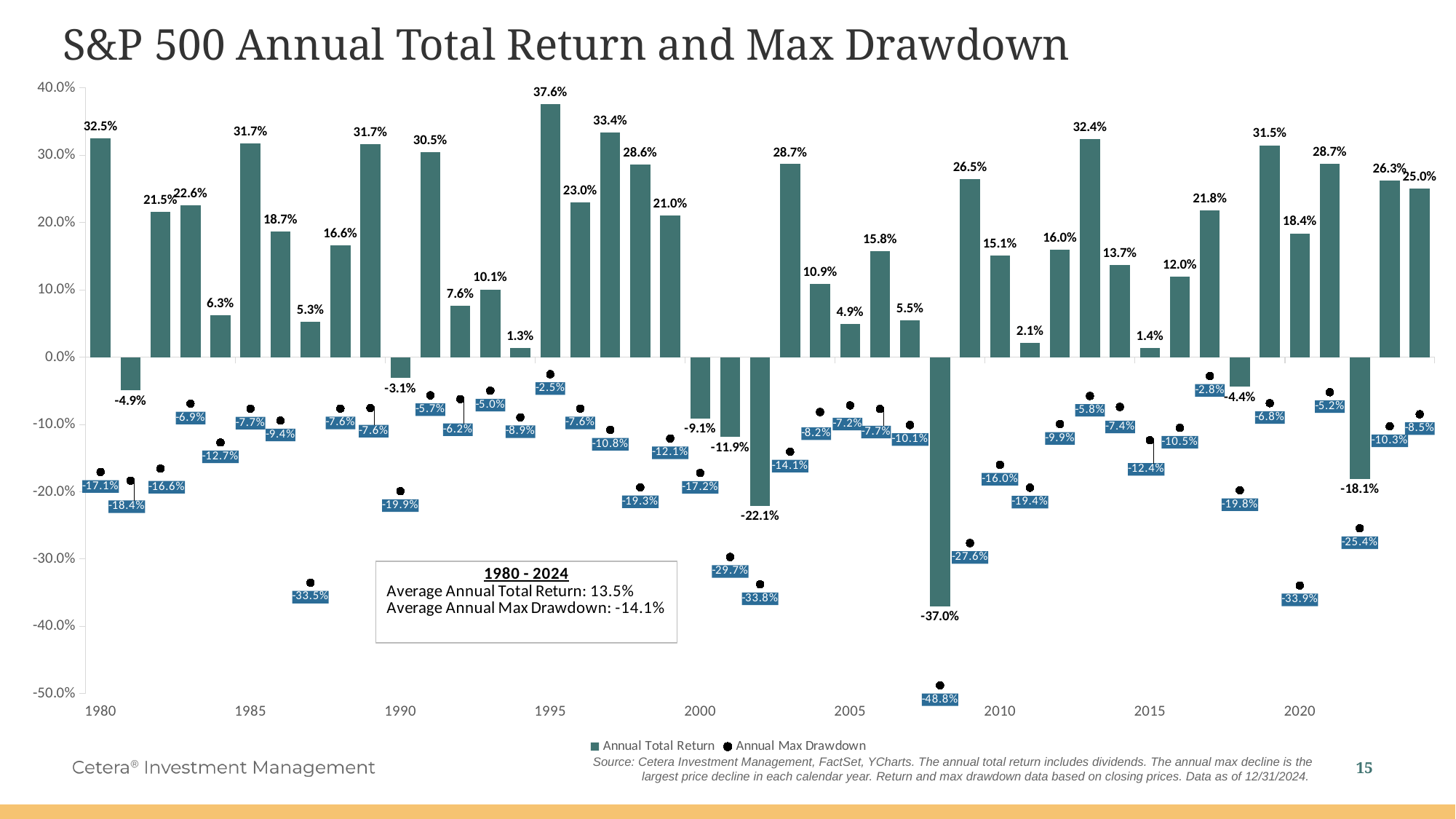
Which year had the highest annual total return? 1995 What was the S&P 500 annual total return in 1995? 37.6% What was the annual max drawdown in 2008? -48.8% What is the average annual max drawdown for 1980-2024 shown in the text box? -14.1% What was the annual total return in 2022? -18.1% Which year had the lowest annual total return? 2008 Which year had the larger annual total return, 2013 or 2019? 2013 How many years are plotted on the chart? 45 What is the average annual total return for 1980-2024 shown in the text box? 13.5% What is the difference between the annual total return in 2023 and in 2024? 1.3 percentage points What was the annual max drawdown in 2020? -33.9% How many series does the legend list? 2